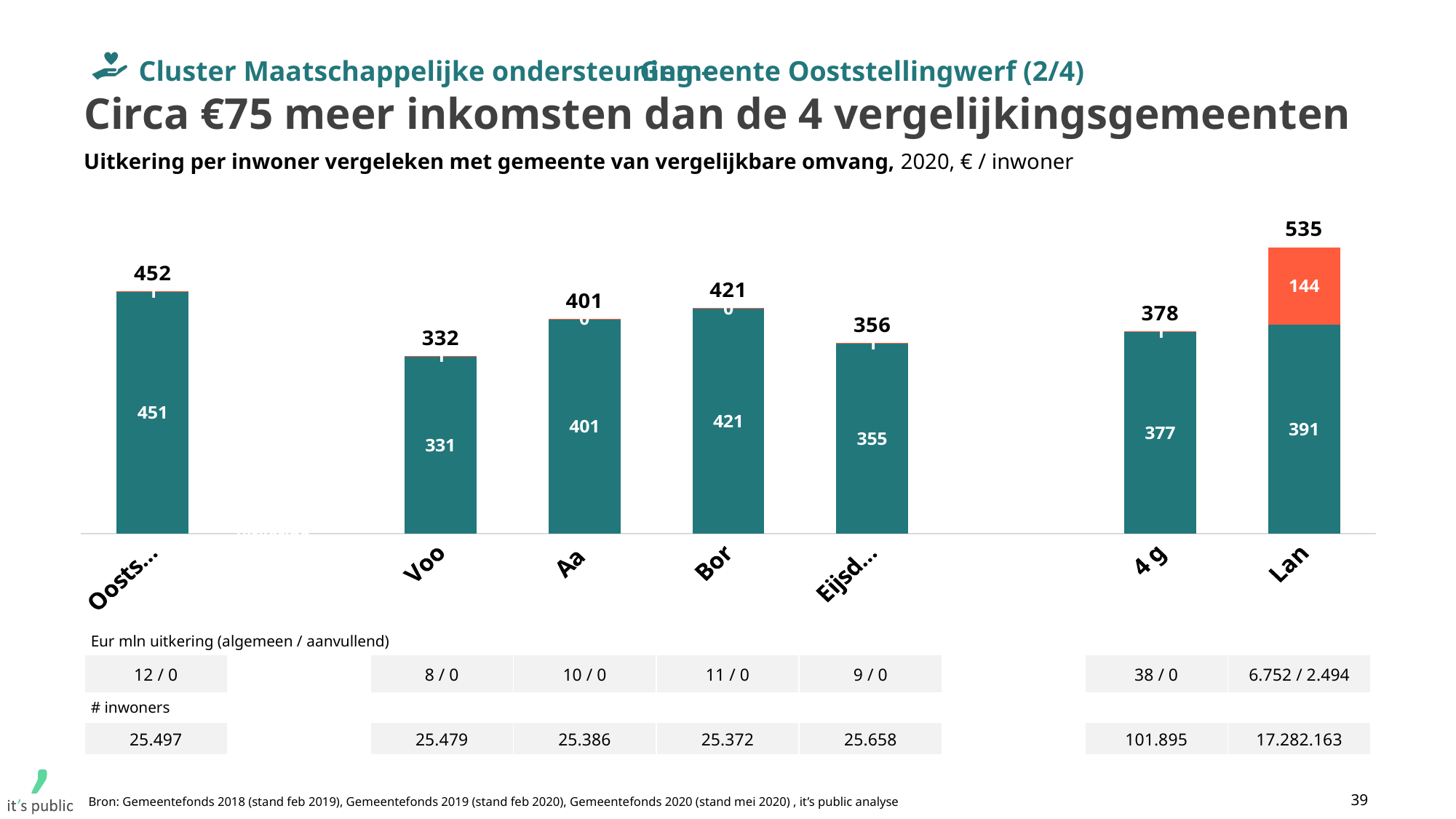
What is the difference between the total for Oosts... and the total for 4 g? 74 What is the difference between the total for Lan and the total for Oosts...? 83 Which category has the lowest total value? Voo What value is printed in the orange segment of the Lan bar? 144 What value is printed inside the teal segment of the bar for 4 g? 377 What unit is stated in the chart subtitle for the values? € / inwoner Which category has the highest total value? Lan What kind of chart is shown on the slide? Stacked bar chart What is the total value shown above the bar for Lan? 535 Which has a larger total value, Bor or Aa? Bor How many bars are shown in the chart? 7 What is the total value shown above the bar for Bor? 421